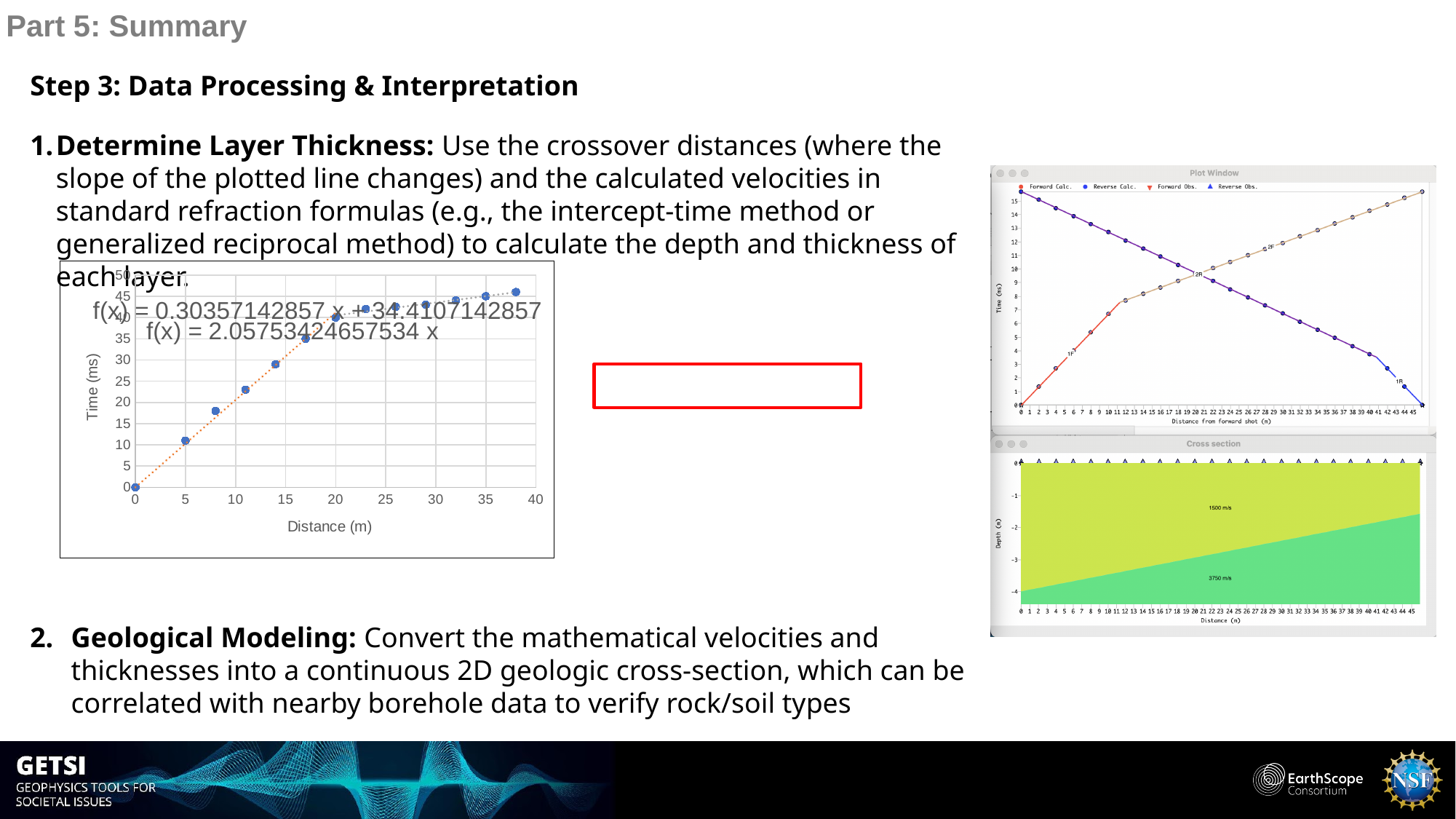
On the left chart, is the time value at a distance of 8 m greater or less than 20? less On the left chart, do the plotted time values rise or fall as distance increases? rise On the left chart, at which distance is the plotted time value lowest? 0 On the left chart, what is the label of the vertical axis? Time (ms) In the Plot Window chart on the right, how many series does the legend list? 4 On the left chart, at which distance is the plotted time value highest? 38 On the left chart, what is the time value at a distance of 0 m? 0 On the left chart, is the time value at a distance of 26 m greater or less than 40? greater On the left chart, what is the label of the horizontal axis? Distance (m) What kind of chart is the Time (ms) versus Distance (m) chart on the left of the slide? scatter chart On the left chart, is the time value at a distance of 11 m greater or less than 20? greater On the left chart, how many data points are plotted? 13